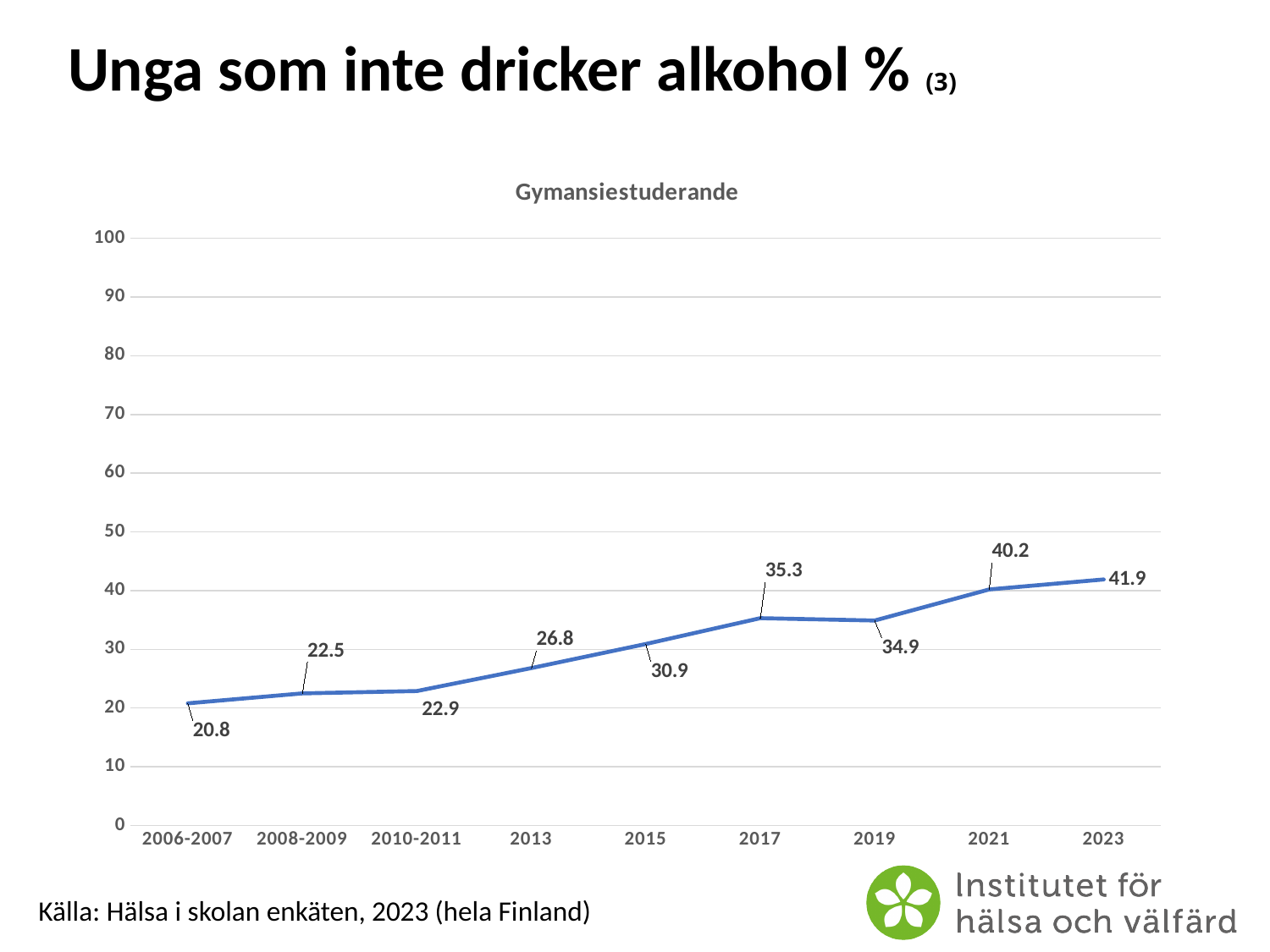
How many data points are plotted on the chart? 9 What is the value for 2023? 41.9 Which is larger, the value for 2017 or the value for 2019? 2017 What is the value for 2013? 26.8 Which period has the highest value? 2023 Is the value for 2021 greater or less than 50? less What is the title of the chart? Gymansiestuderande Which period has the lowest value? 2006-2007 What is the value for 2017? 35.3 What is the value for 2006-2007? 20.8 What is the difference between the values for 2023 and 2006-2007? 21.1 What kind of chart is shown on the slide? line chart